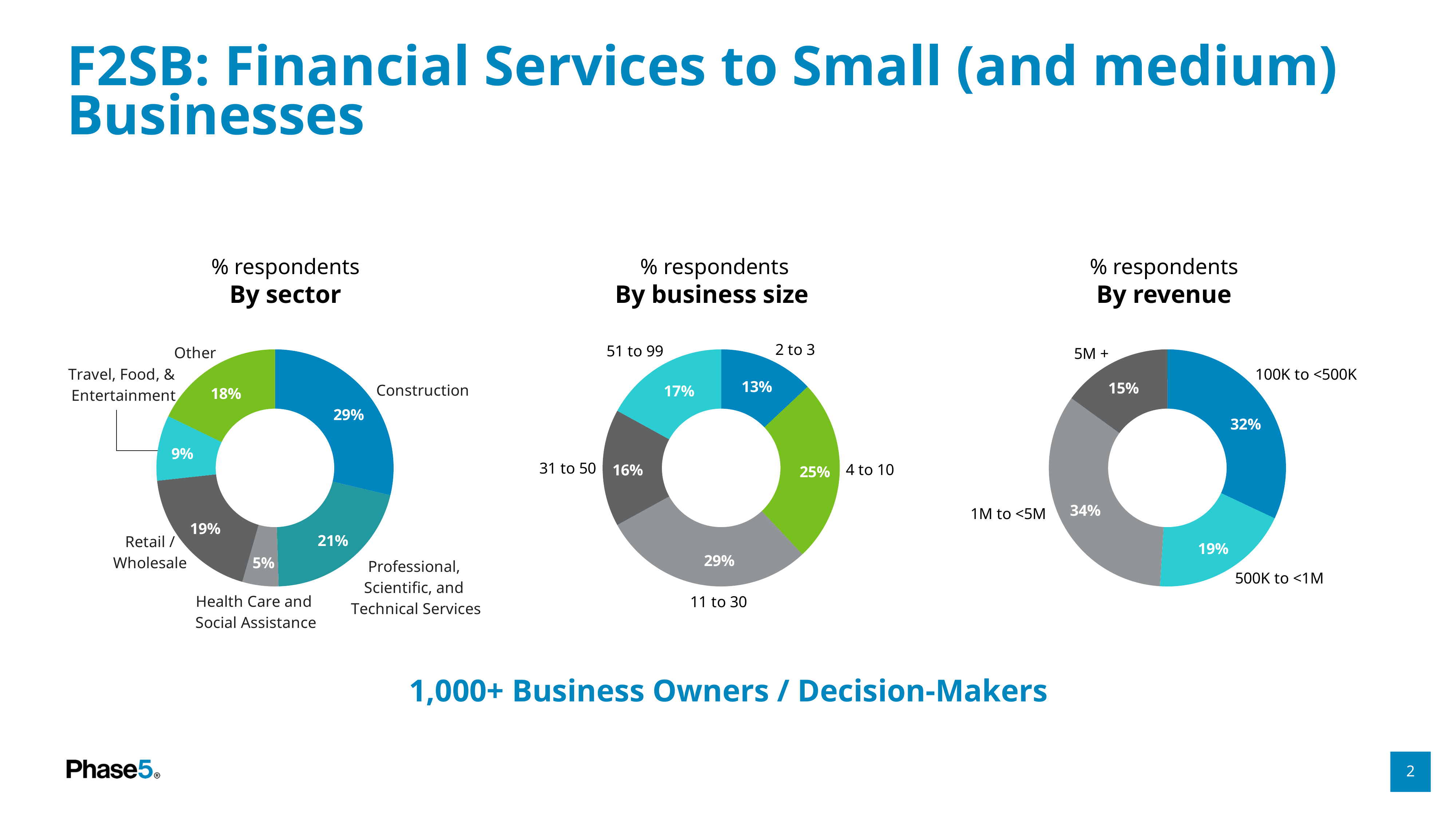
In the 'By revenue' chart, what is the difference between the 100K to <500K share and the 500K to <1M share? 13% What type of chart is used for the 'By revenue' breakdown? Pie chart (donut) In the 'By sector' chart, what percentage of respondents are in Construction? 29% In the 'By business size' chart, what percentage of respondents have 4 to 10 employees? 25% In the 'By sector' chart, which sector has the smallest share of respondents? Health Care and Social Assistance In the 'By business size' chart, which is larger: the share for 51 to 99 or the share for 2 to 3? 51 to 99 In the 'By sector' chart, what is the difference between the Retail / Wholesale share and the Travel, Food, & Entertainment share? 10% How many revenue bands are shown in the 'By revenue' chart? 4 In the 'By revenue' chart, which revenue band has the largest share of respondents? 1M to <5M In the 'By revenue' chart, what percentage of respondents have revenue of 5M +? 15% In the 'By business size' chart, which business size has the largest share of respondents? 11 to 30 How many sectors are shown in the 'By sector' chart? 6